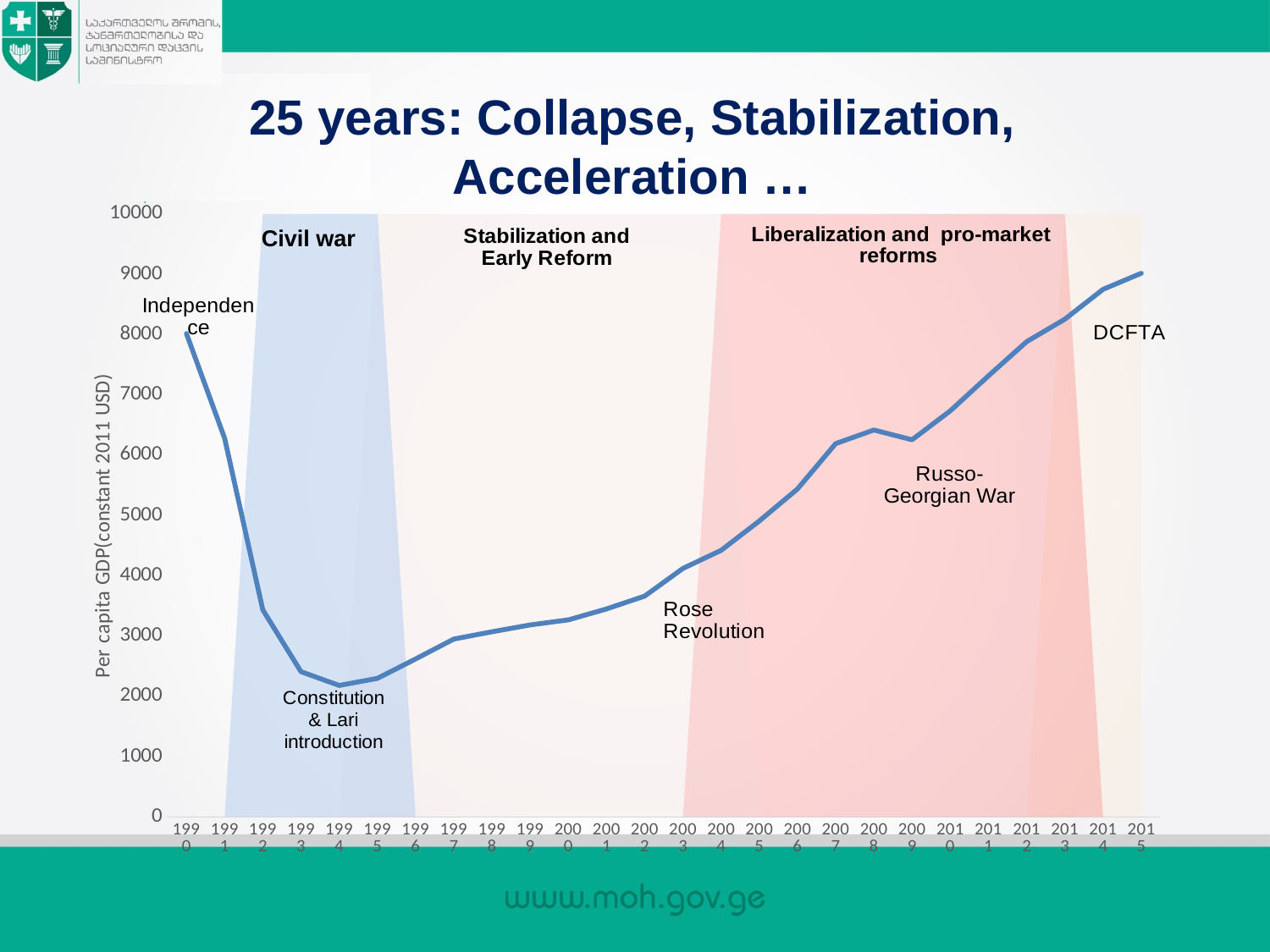
Does per capita GDP rise or fall overall between 1994 and 2015? rise Which year has the larger per capita GDP, 1994 or 2003? 2003 Does per capita GDP rise or fall between 1990 and 1994? fall How many years (data points) are plotted along the x axis? 26 Is the value for 1994 greater or less than 3000? less What is the label on the y axis of the chart? Per capita GDP(constant 2011 USD) What kind of chart is shown on the slide? line chart Is the value for 1991 greater or less than 5000? greater Is the value for 2015 greater or less than 8000? greater In which year is per capita GDP at its lowest? 1994 In which year is per capita GDP at its highest? 2015